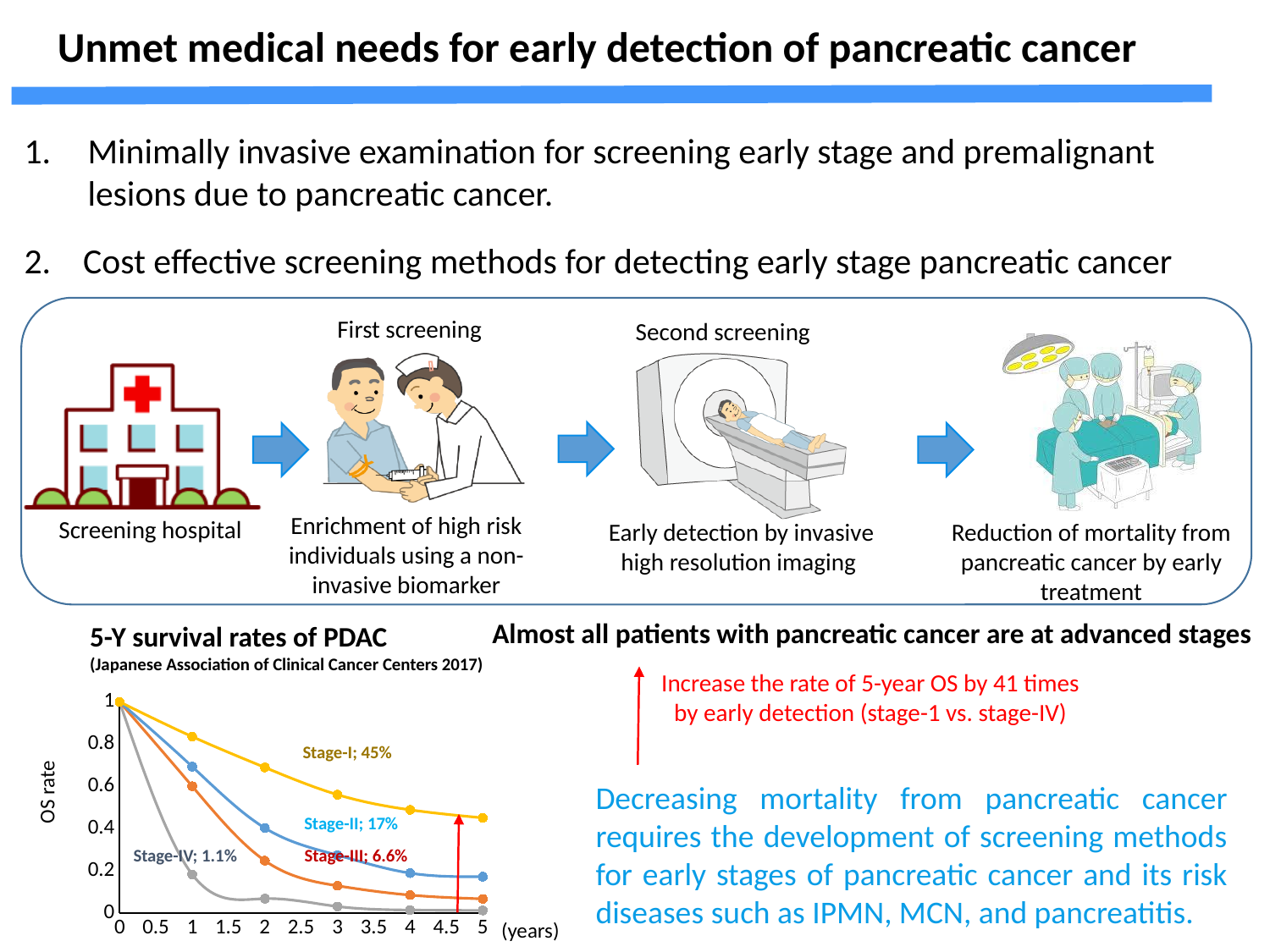
In the "5-Y survival rates of PDAC" chart, what is the 5-year survival rate for Stage-III? 6.6% In the "5-Y survival rates of PDAC" chart, is the Stage-I OS rate at 3 years greater or less than 0.4? greater In the "5-Y survival rates of PDAC" chart, which has the higher 5-year survival rate, Stage-II or Stage-III? Stage-II In the "5-Y survival rates of PDAC" chart, what is the 5-year survival rate for Stage-IV? 1.1% In the "5-Y survival rates of PDAC" chart, what is the 5-year survival rate for Stage-II? 17% In the "5-Y survival rates of PDAC" chart, what is the difference between the 5-year survival rates of Stage-I and Stage-II? 28% In the "5-Y survival rates of PDAC" chart, which stage has the highest 5-year survival rate? Stage-I In the "5-Y survival rates of PDAC" chart, what is the 5-year survival rate for Stage-I? 45% In the "5-Y survival rates of PDAC" chart, does the OS rate rise or fall as the years increase? fall What kind of chart is the "5-Y survival rates of PDAC" chart? line chart How many stage lines are plotted in the "5-Y survival rates of PDAC" chart? 4 In the "5-Y survival rates of PDAC" chart, which stage has the lowest 5-year survival rate? Stage-IV